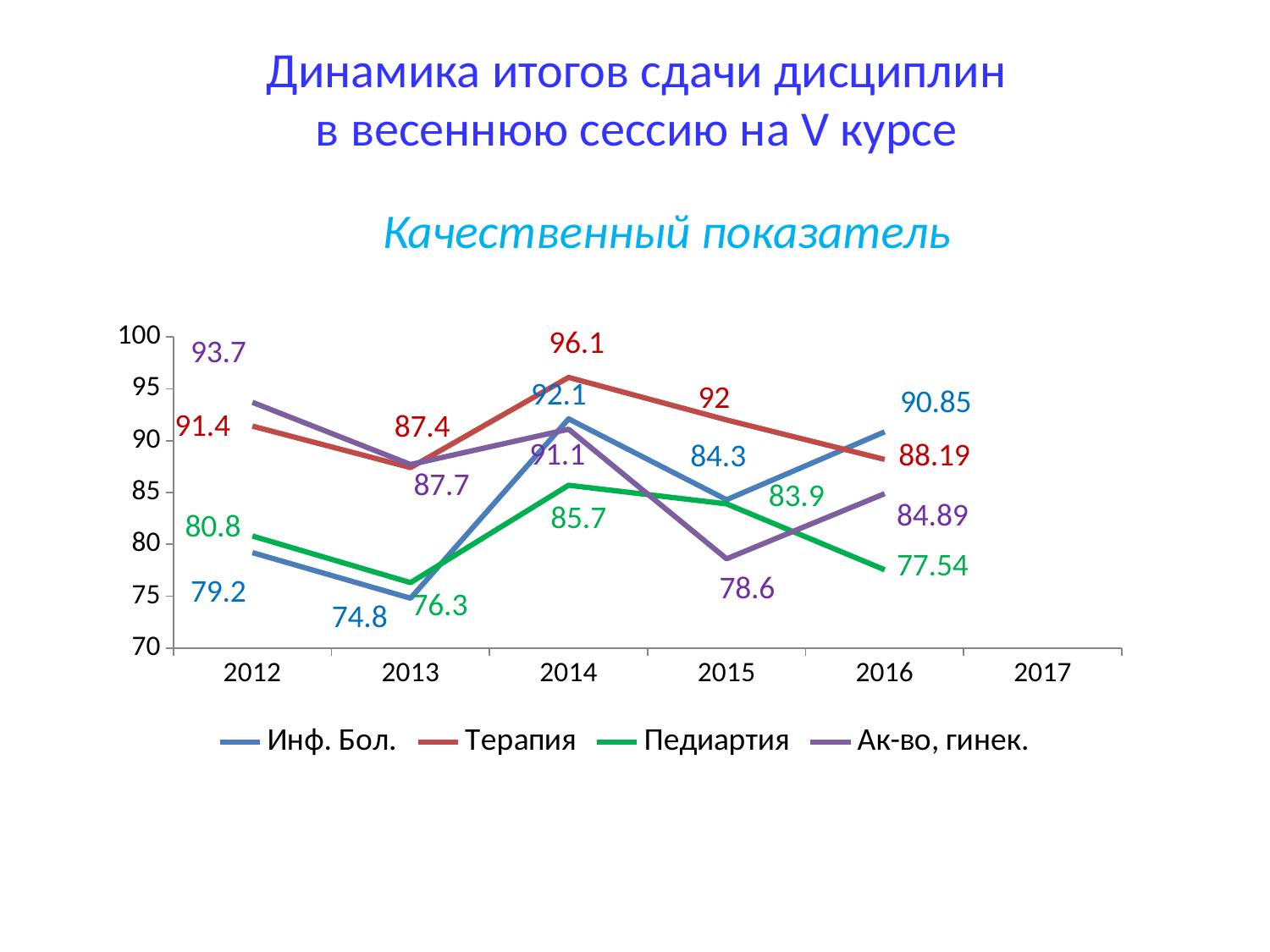
Does the value for Педиартия rise or fall from 2015 to 2016? Fall What kind of chart is shown on the slide? Line chart What is the value for Педиартия in 2016? 77.54 In which year does Терапия reach its highest value? 2014 What is the value for Инф. Бол. in 2013? 74.8 In which year does Инф. Бол. have its lowest value? 2013 What is the subtitle shown directly above the chart? Качественный показатель By how much did Терапия increase from 2013 to 2014? 8.7 How many series does the legend list? 4 What is the value for Терапия in 2014? 96.1 What is the value for Ак-во, гинек. in 2015? 78.6 In 2016, which is larger: Инф. Бол. or Терапия? Инф. Бол.